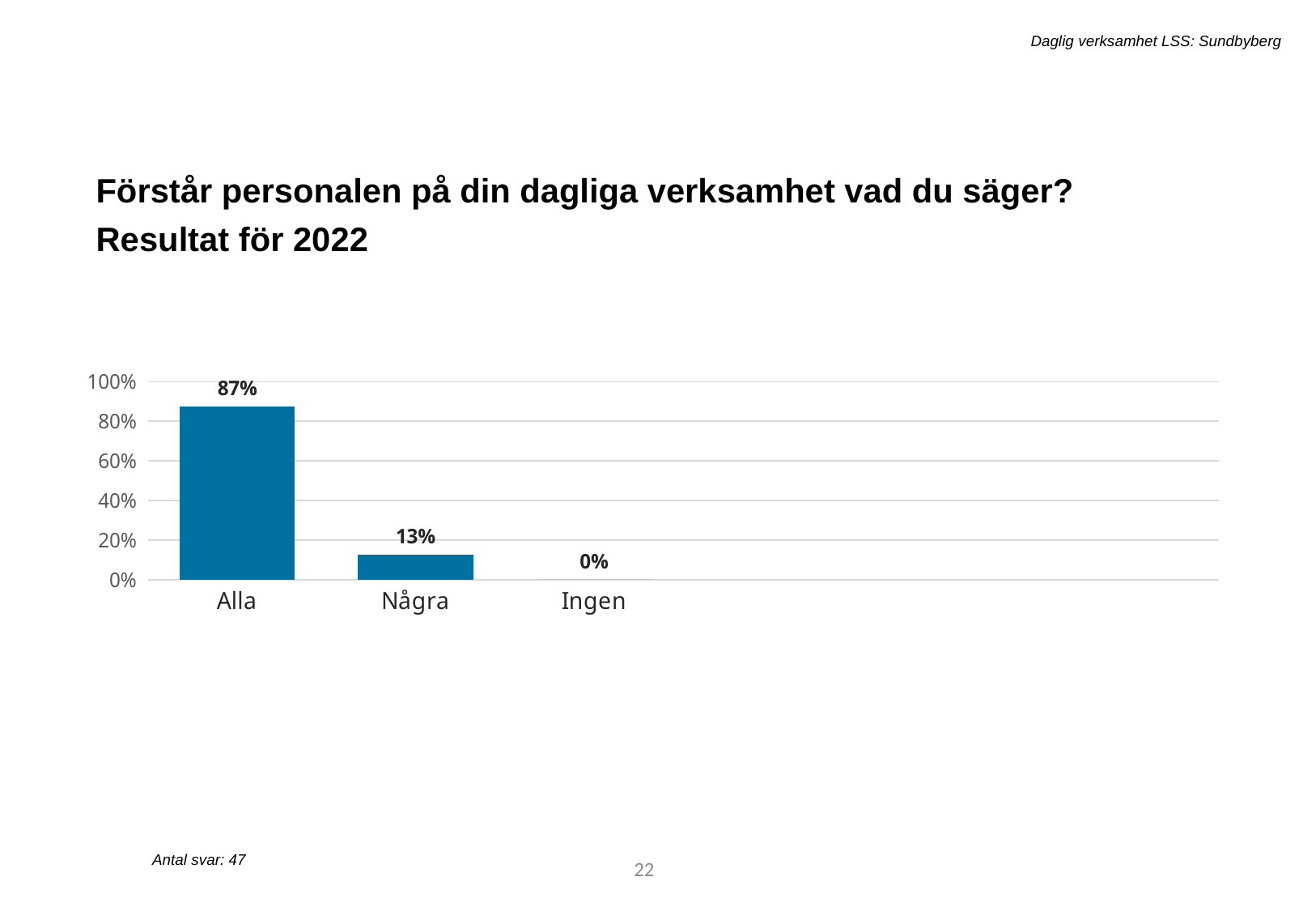
Is the value for Några greater or less than 20%? less What is the value for Ingen? 0% Do the values rise or fall from left to right along the x axis? Fall Is the value for Alla greater or less than 80%? greater What kind of chart is shown on the slide? Bar chart Which category has the highest value? Alla Which category has the lowest value? Ingen Which is larger, the value for Några or the value for Ingen? Några What is the difference between the values for Alla and Några? 74 percentage points What is the value for Några? 13% What is the value for Alla? 87% How many categories are shown on the x axis? 3